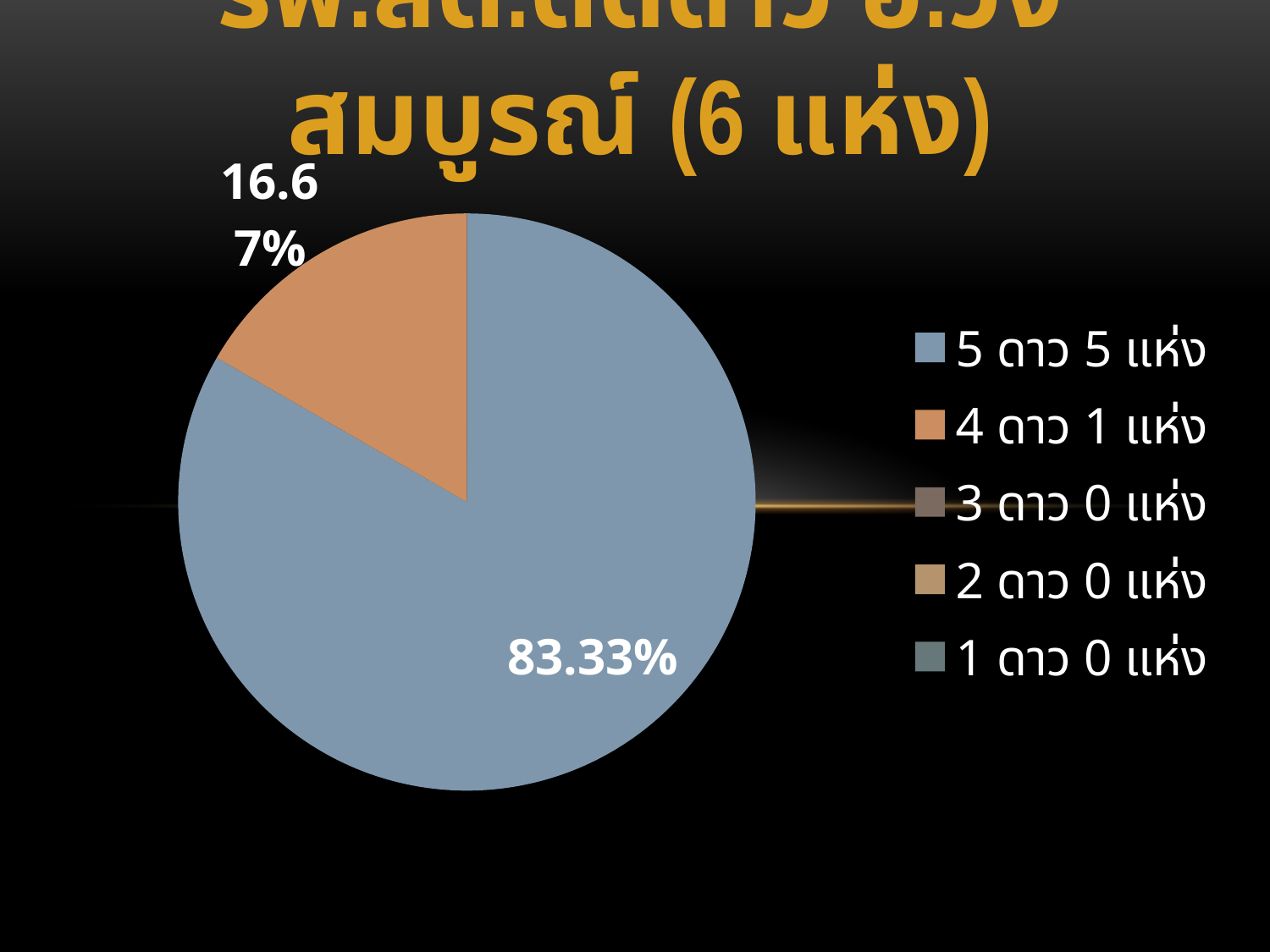
Which category has the largest slice of the pie? 5 ดาว 5 แห่ง What kind of chart is shown on the slide? pie chart How many slices are visible in the pie? 2 How many entries does the legend list? 5 Which is larger, the slice for 5 ดาว 5 แห่ง or the slice for 4 ดาว 1 แห่ง? 5 ดาว 5 แห่ง What percentage is shown for the 5 ดาว 5 แห่ง slice? 83.33% What colour is the slice for 4 ดาว 1 แห่ง? orange What percentage is shown for the 4 ดาว 1 แห่ง slice? 16.67% How many legend entries show 0 แห่ง? 3 What colour is the slice for 5 ดาว 5 แห่ง? blue-grey What is the difference in percentage points between the 5 ดาว 5 แห่ง slice and the 4 ดาว 1 แห่ง slice? 66.66%